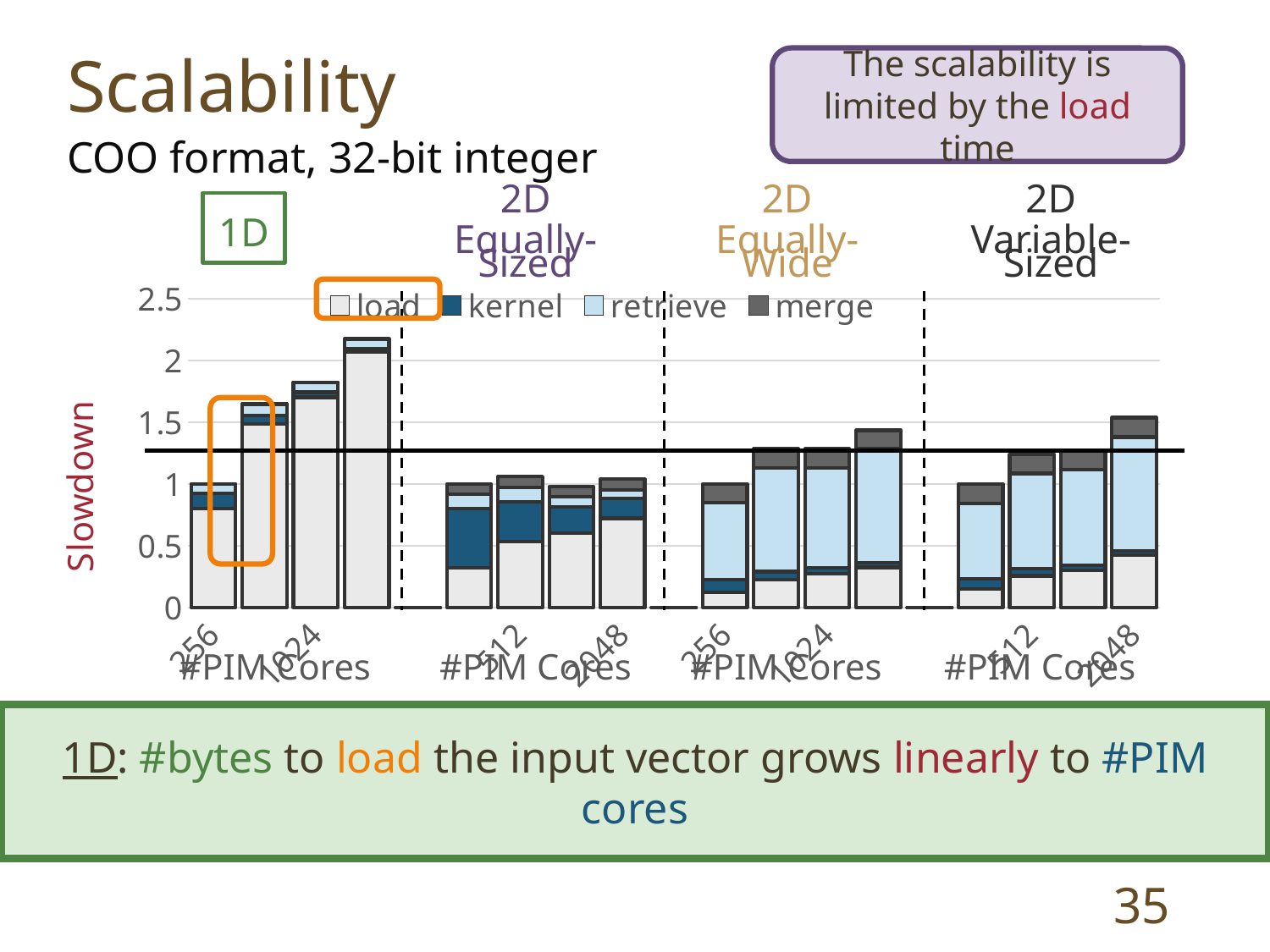
How many partitioning groups (separated by dashed lines) does the chart show? 4 Which group contains the tallest bar in the chart? 1D What kind of chart is shown on the slide? stacked bar chart Is the total slowdown for 2048 PIM cores in the 1D group greater or less than 2? greater Is the total slowdown for 2048 PIM cores in the 2D Equally-Wide group greater or less than 1.5? less In the 1D group, which #PIM cores value has the highest slowdown? 2048 In the 1D group, does the slowdown rise or fall as #PIM cores increases? rise How many series does the chart legend list? 4 What is the label of the y axis of the chart? Slowdown Which series are listed in the chart legend? load, kernel, retrieve, merge Which is larger: the total slowdown for 2048 PIM cores in the 1D group or in the 2D Equally-Sized group? 1D How many bars are plotted in the 1D group of the chart? 4